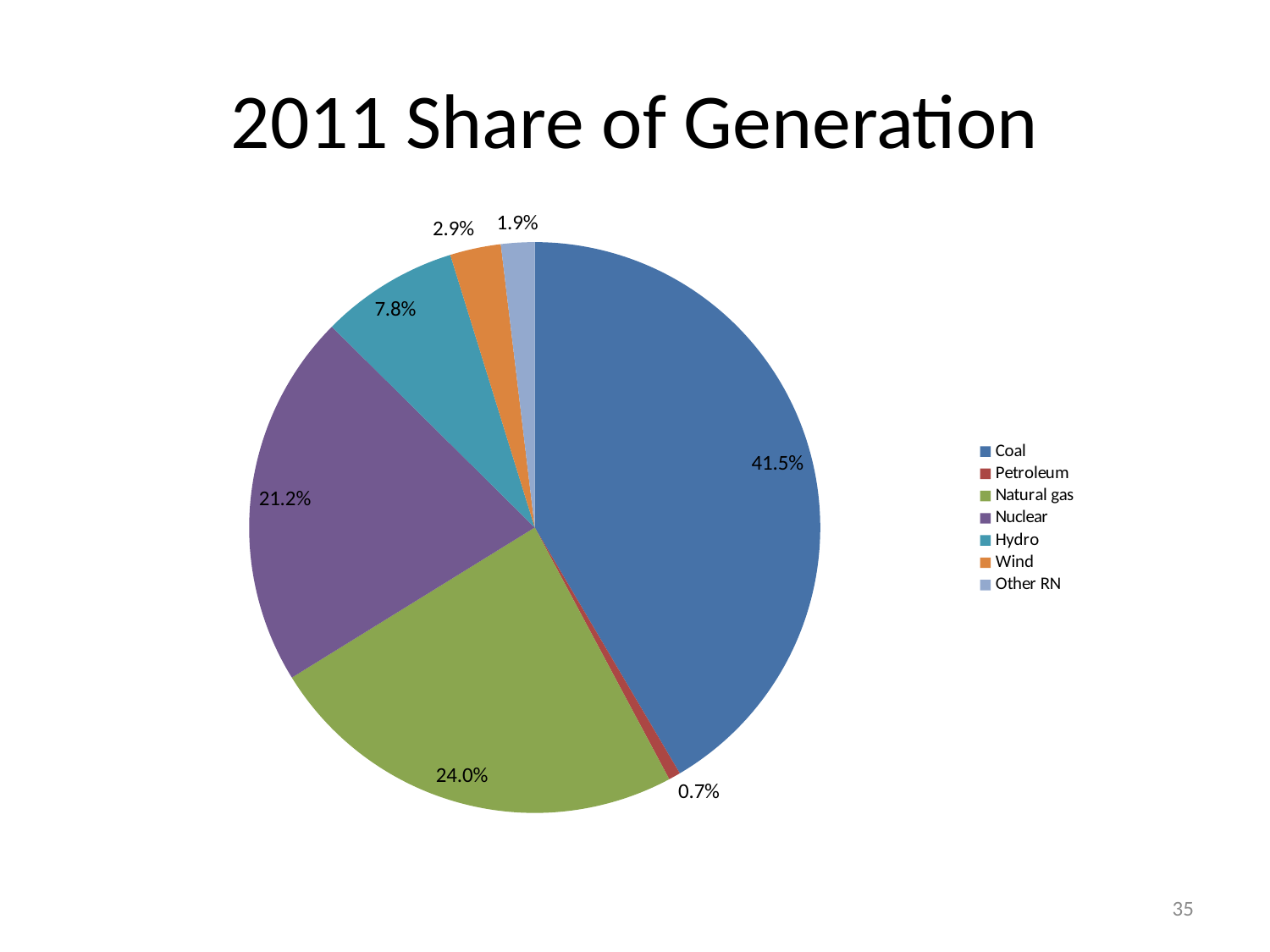
What share of generation does Coal have? 41.5% What share of generation does Wind have? 2.9% What share of generation does Natural gas have? 24.0% What share of generation does Nuclear have? 21.2% What type of chart is shown on the slide? Pie chart Which source has the smallest share of generation? Petroleum What share of generation does Hydro have? 7.8% Which source has the largest share of generation? Coal What share of generation does Petroleum have? 0.7% What is the difference in share between Coal and Natural gas? 17.5% How many sources are shown in the pie chart? 7 Which has a larger share, Nuclear or Hydro? Nuclear